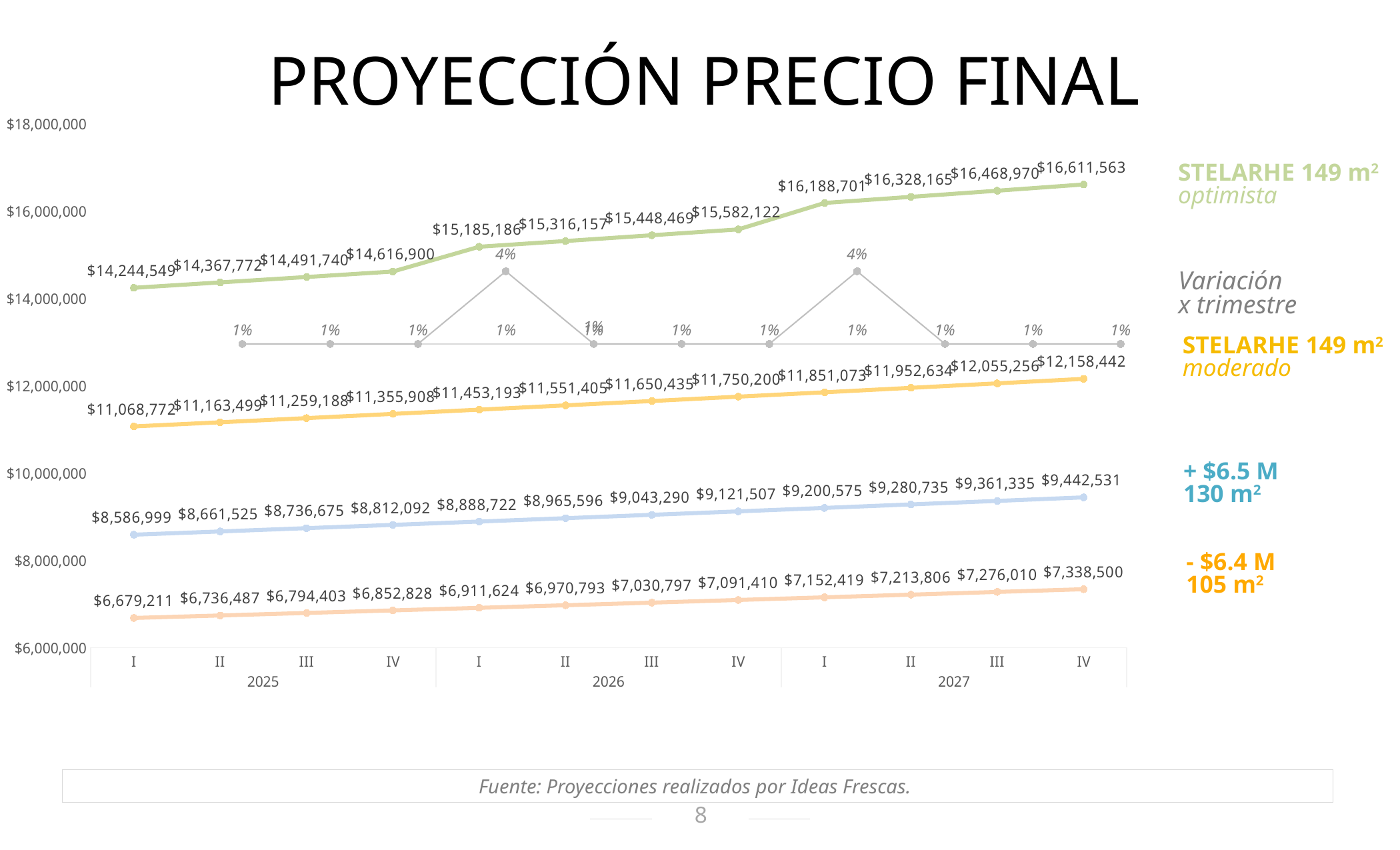
What kind of chart is shown on the slide? line chart What is the value of the STELARHE 149 m² moderado series in quarter IV of 2027? $12,158,442 Does the STELARHE 149 m² optimista series rise or fall from quarter I of 2025 to quarter IV of 2027? rise How many quarters are plotted along the x axis? 12 What is the value of the - $6.4 M 105 m² series in quarter IV of 2027? $7,338,500 In which quarter does the STELARHE 149 m² optimista series reach its highest value? IV 2027 What is the title of the chart? PROYECCIÓN PRECIO FINAL What is the Variación x trimestre value shown in quarter I of 2026? 4% What is the difference between the STELARHE 149 m² optimista values in quarter IV of 2027 and quarter I of 2025? $2,367,014 What is the value of the + $6.5 M 130 m² series in quarter I of 2026? $8,888,722 In quarter IV of 2027, which is larger: the STELARHE 149 m² moderado value or the + $6.5 M 130 m² value? STELARHE 149 m² moderado What is the value of the STELARHE 149 m² optimista series in quarter I of 2025? $14,244,549